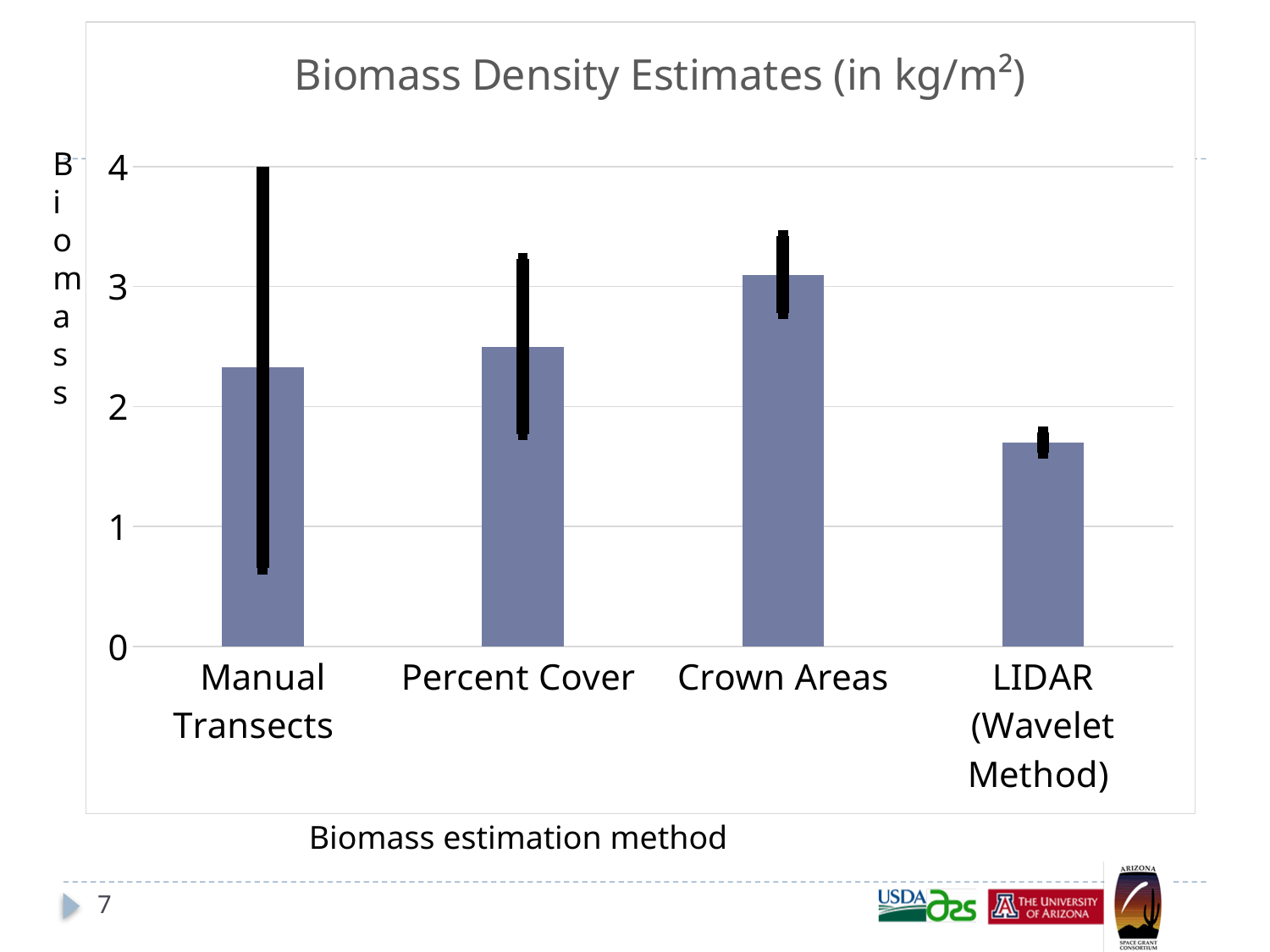
What kind of chart is shown on the slide? bar chart How many biomass estimation methods are plotted on the chart? 4 Which biomass estimation method has the lowest biomass density estimate? LIDAR (Wavelet Method) Which is larger, the value for Crown Areas or the value for LIDAR (Wavelet Method)? Crown Areas What is the title of the chart? Biomass Density Estimates (in kg/m²) What is the label of the x axis? Biomass estimation method Which biomass estimation method has the highest biomass density estimate? Crown Areas Which is larger, the value for Percent Cover or the value for LIDAR (Wavelet Method)? Percent Cover Is the value for Manual Transects greater or less than 2? greater Is the value for LIDAR (Wavelet Method) greater or less than 2? less Is the value for Crown Areas greater or less than 3? greater